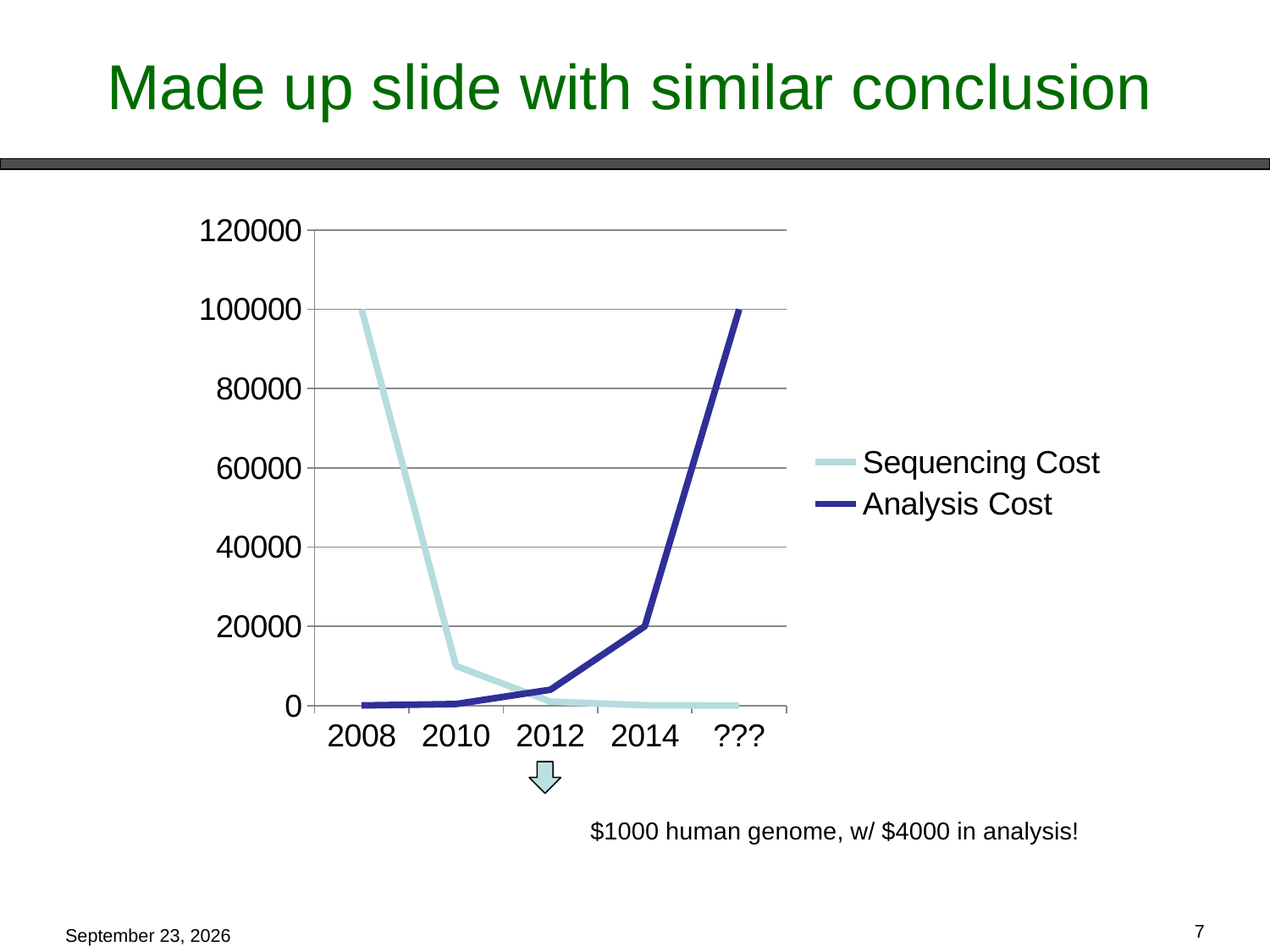
What is the Sequencing Cost value for 2008? 100000 How many categories are shown on the x axis? 5 In 2008, which is larger: Sequencing Cost or Analysis Cost? Sequencing Cost What are the two series named in the legend? Sequencing Cost and Analysis Cost Does the Analysis Cost line rise or fall from 2008 to ??? Rise For which category is Analysis Cost highest? ??? Is the Sequencing Cost value for 2010 greater or less than 20000? less What kind of chart is shown on the slide? Line chart What is the Analysis Cost value for 2014? 20000 What is the Analysis Cost value for the category labelled ??? 100000 How many series does the legend list? 2 Does the Sequencing Cost line rise or fall from 2008 to ??? Fall